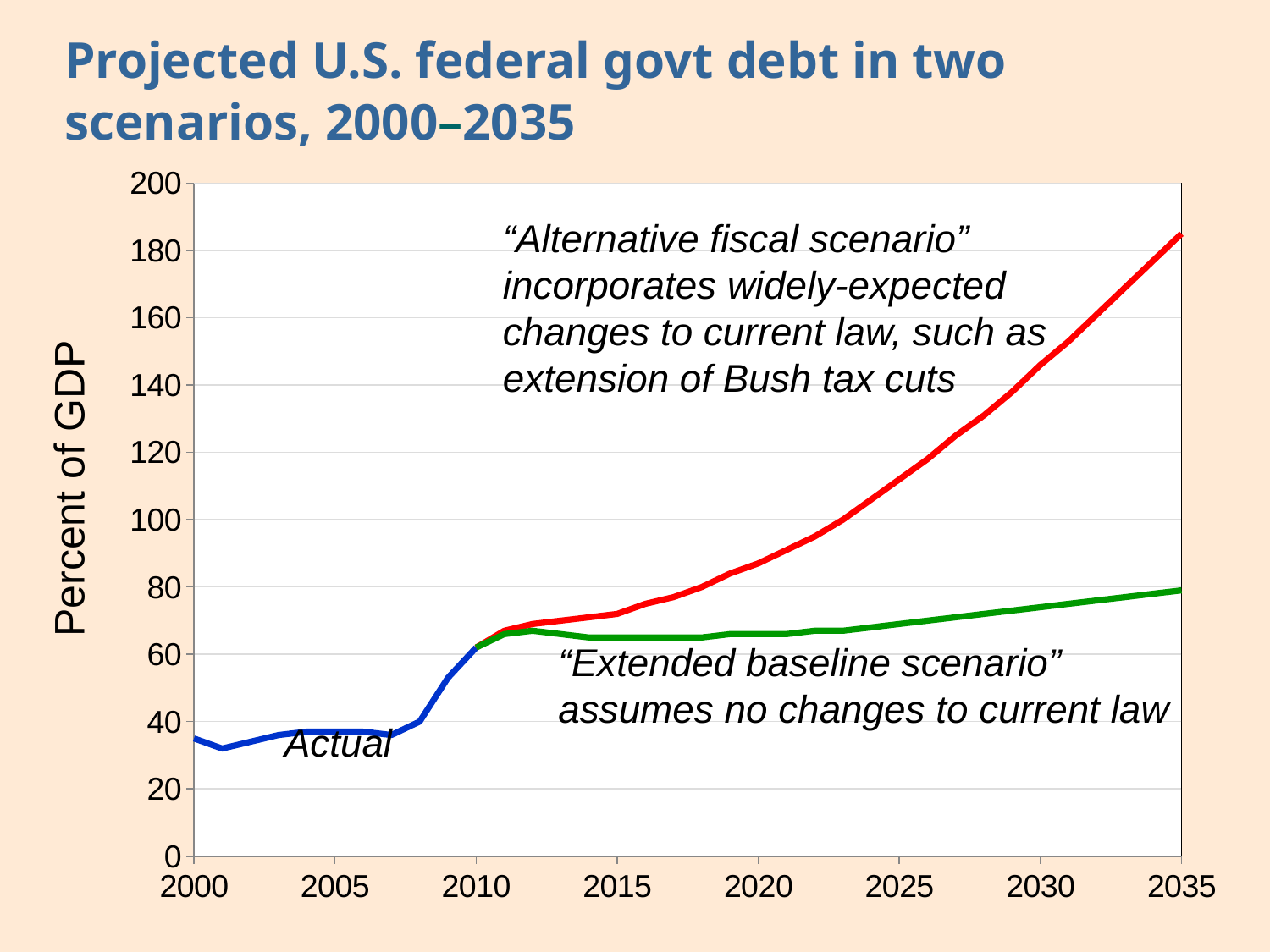
Does the "Actual" line rise or fall overall from 2000 to 2010? rise Is the value of the "Extended baseline scenario" line in 2020 greater or less than 80? less Is the value of the "Extended baseline scenario" line in 2035 greater or less than 100? less Is the value of the "Actual" line in 2000 greater or less than 40? less What is the label on the vertical axis of the chart? Percent of GDP Does the "Alternative fiscal scenario" line rise or fall from 2010 to 2035? rise How many lines (series) are plotted on the chart? 3 What kind of chart is shown on the slide? line chart What is the title of the chart on the slide? Projected U.S. federal govt debt in two scenarios, 2000–2035 In 2035, which line is higher: the "Alternative fiscal scenario" or the "Extended baseline scenario"? Alternative fiscal scenario